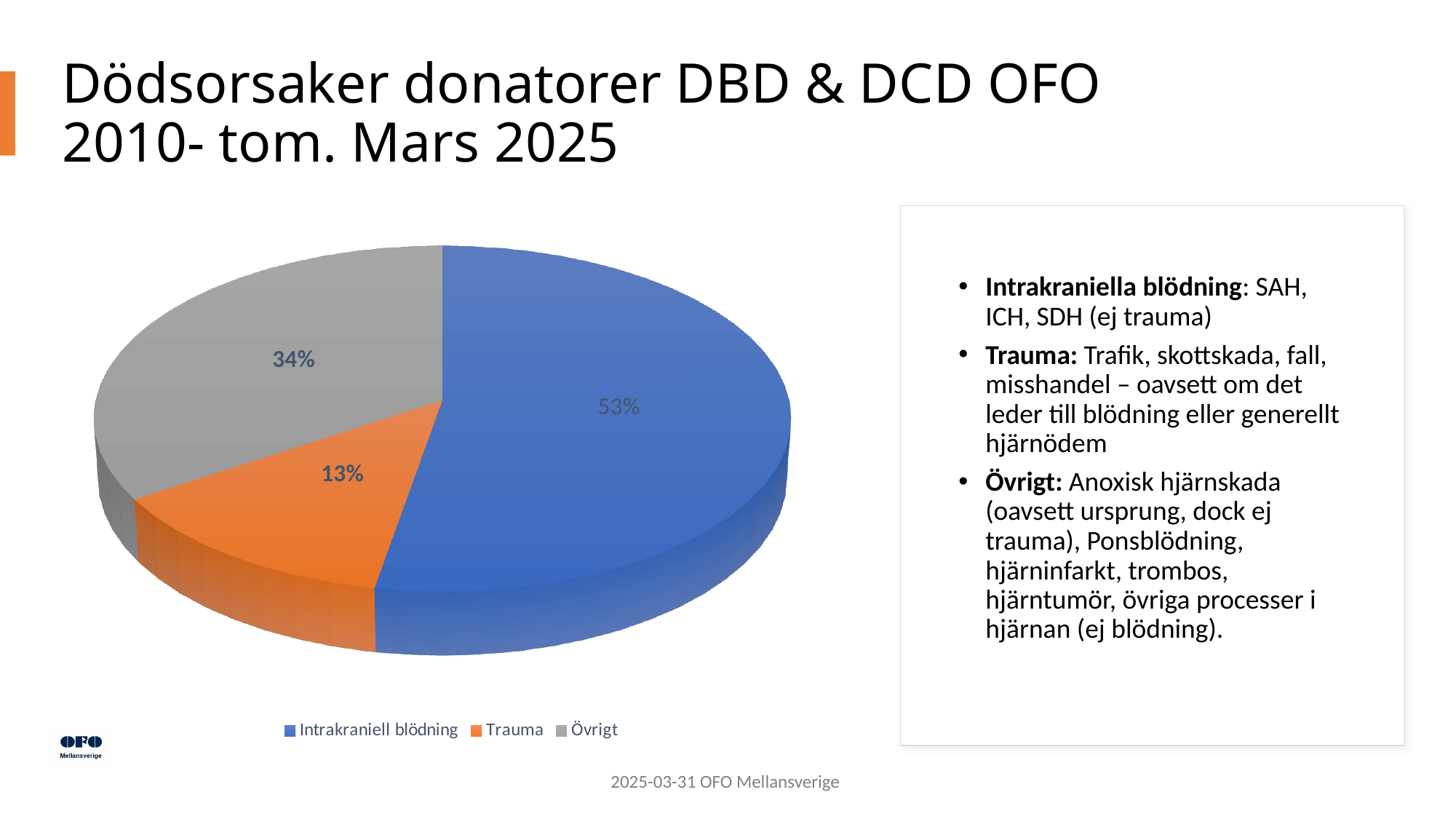
Which is larger, the Trauma slice or the Övrigt slice? Övrigt What is the difference in percentage points between the Intrakraniell blödning slice and the Övrigt slice? 19 What share of the pie does Trauma account for? 13% What share of the pie does Övrigt account for? 34% Which category has the largest slice of the pie? Intrakraniell blödning Which category is shown in grey in the pie chart? Övrigt What colour is the Trauma slice in the pie chart? Orange What kind of chart is shown on the slide? Pie chart What is the difference in percentage points between the Övrigt slice and the Trauma slice? 21 How many categories are shown in the pie chart? 3 What share of the pie does Intrakraniell blödning account for? 53% Which category has the smallest slice of the pie? Trauma